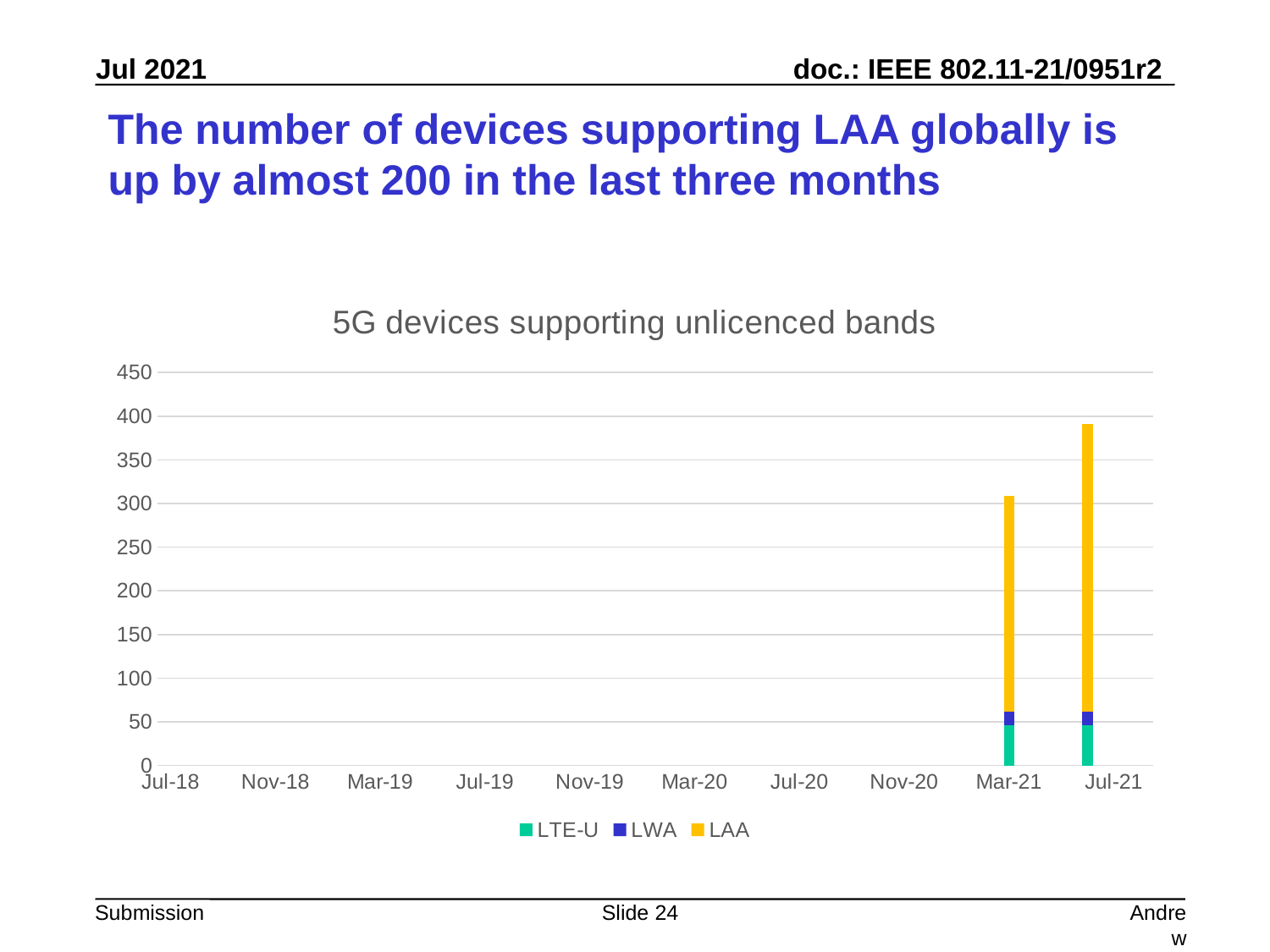
Which series makes up the largest part of the Jul-21 bar? LAA How many series does the legend list? 3 What is the title of the chart? 5G devices supporting unlicenced bands Is the total value of the Mar-21 bar greater or less than 250? greater Which series are listed in the legend? LTE-U, LWA, LAA How many date labels are shown along the x axis? 10 Is the total value of the Jul-21 bar greater or less than 350? greater What kind of chart is shown on the slide? Stacked bar chart Which series makes up the smallest part of the Mar-21 bar? LWA How many dates have a visible bar plotted? 2 Which date has the tallest stacked bar? Jul-21 Is the total stacked bar for Jul-21 larger or smaller than the total for Mar-21? Larger